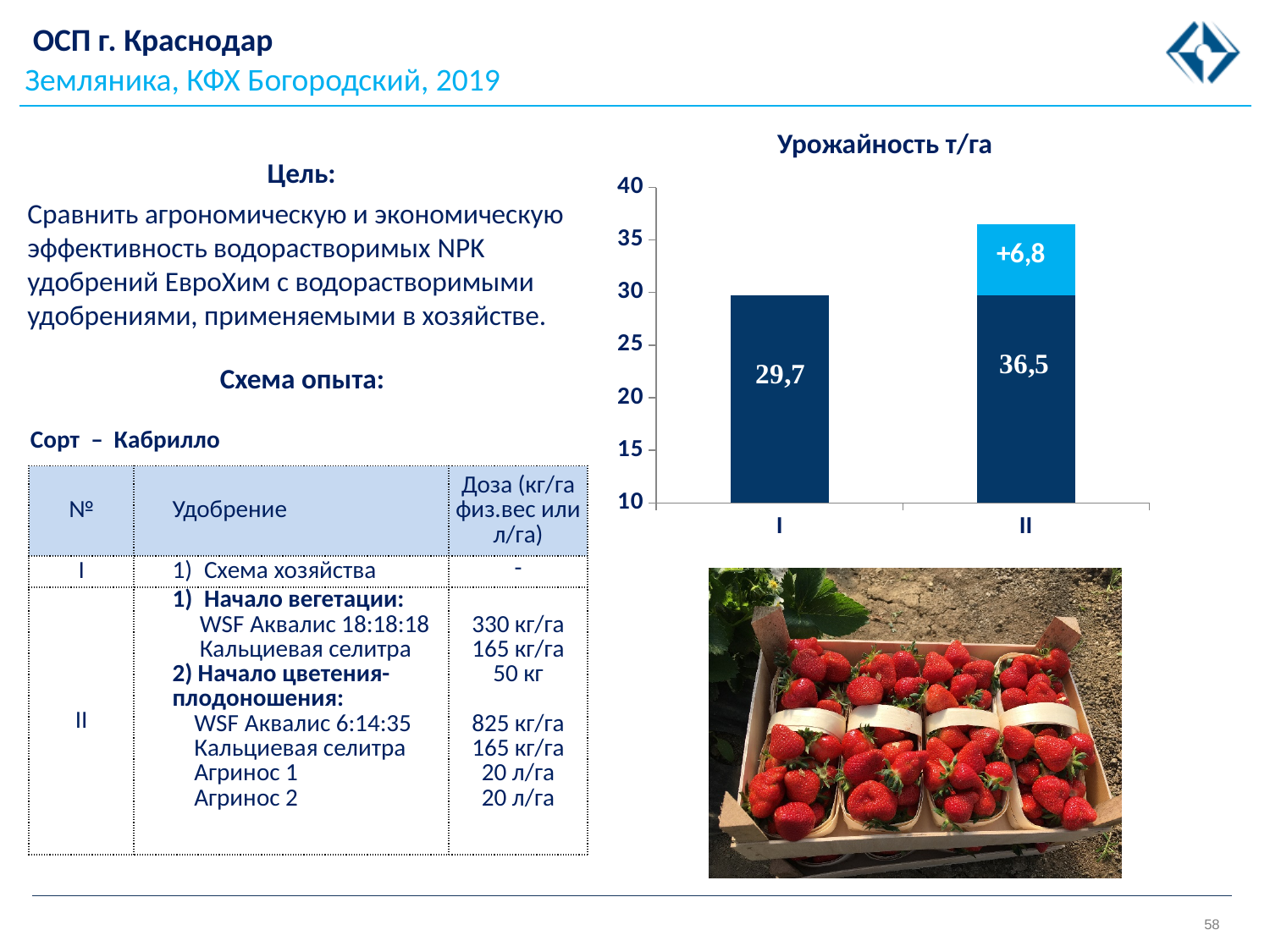
What kind of chart is used to show "Урожайность т/га"? bar chart Which category has the lower yield in the chart "Урожайность т/га"? I What is the title of the chart on the slide? Урожайность т/га Do the values rise or fall from category I to category II in the chart "Урожайность т/га"? rise By how much does the yield of category II exceed that of category I in the chart "Урожайность т/га"? 6,8 Is the yield for category I greater or less than the yield for category II? less How many categories are shown on the x axis of the chart "Урожайность т/га"? 2 Which category has the higher yield in the chart "Урожайность т/га"? II Is the value for category II greater or less than 35 in the chart "Урожайность т/га"? greater What is the yield value shown for category II in the chart "Урожайность т/га"? 36,5 What is the yield value shown for category I in the chart "Урожайность т/га"? 29,7 Is the value for category I greater or less than 30 in the chart "Урожайность т/га"? less